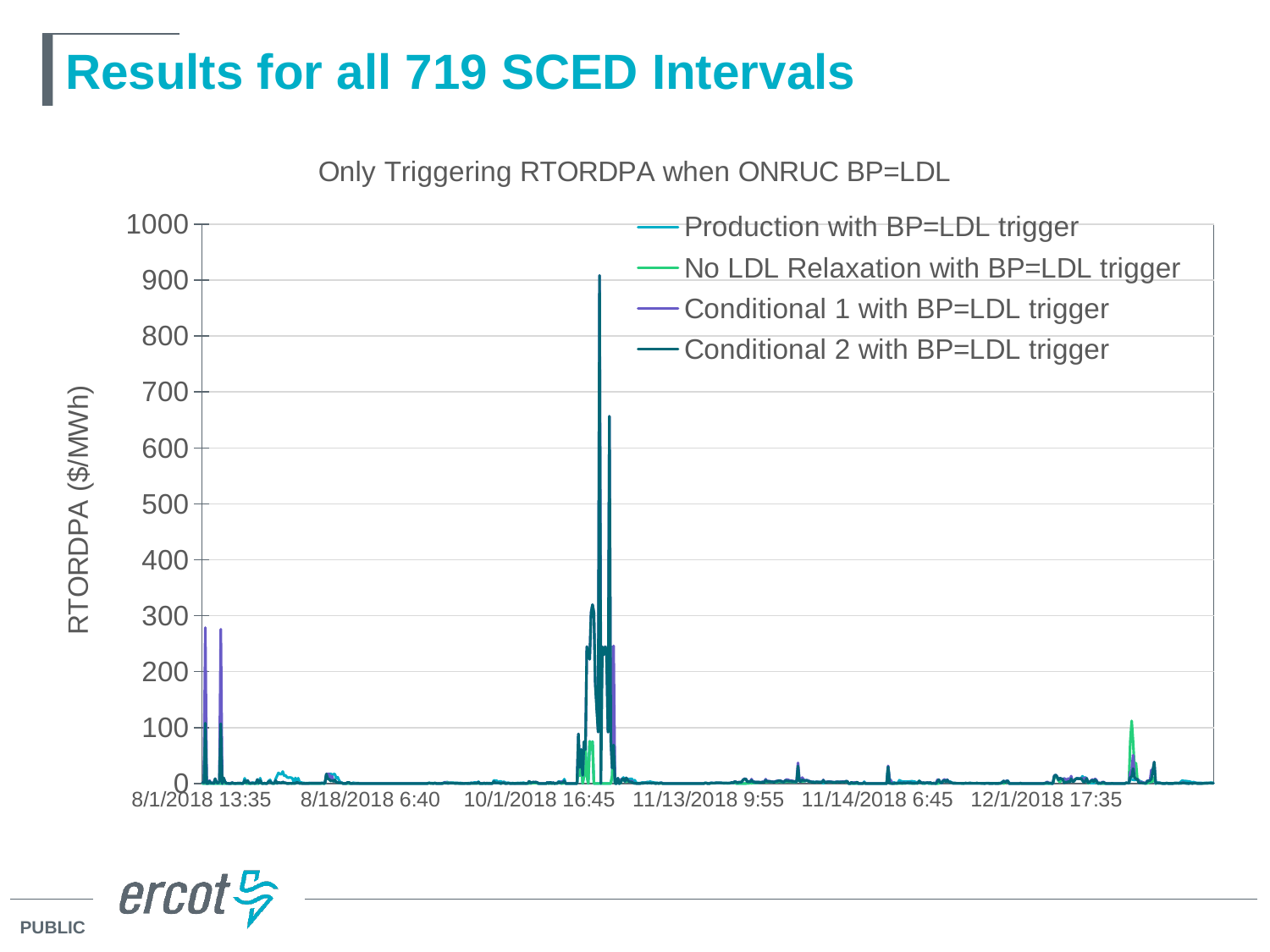
What is the label on the chart's vertical axis? RTORDPA ($/MWh) What kind of chart is shown on the slide? line chart Are the spikes near 8/1/2018 13:35 greater or less than 300 $/MWh? less Is the spike near 12/1/2018 17:35 greater or less than 200 $/MWh? less What is the highest value shown on the vertical axis? 1000 How many series does the chart's legend list? 4 Is the second-highest spike on the chart, just after 10/1/2018 16:45, greater or less than 600 $/MWh? greater What is the title of the chart? Only Triggering RTORDPA when ONRUC BP=LDL How many date labels are shown along the x axis? 6